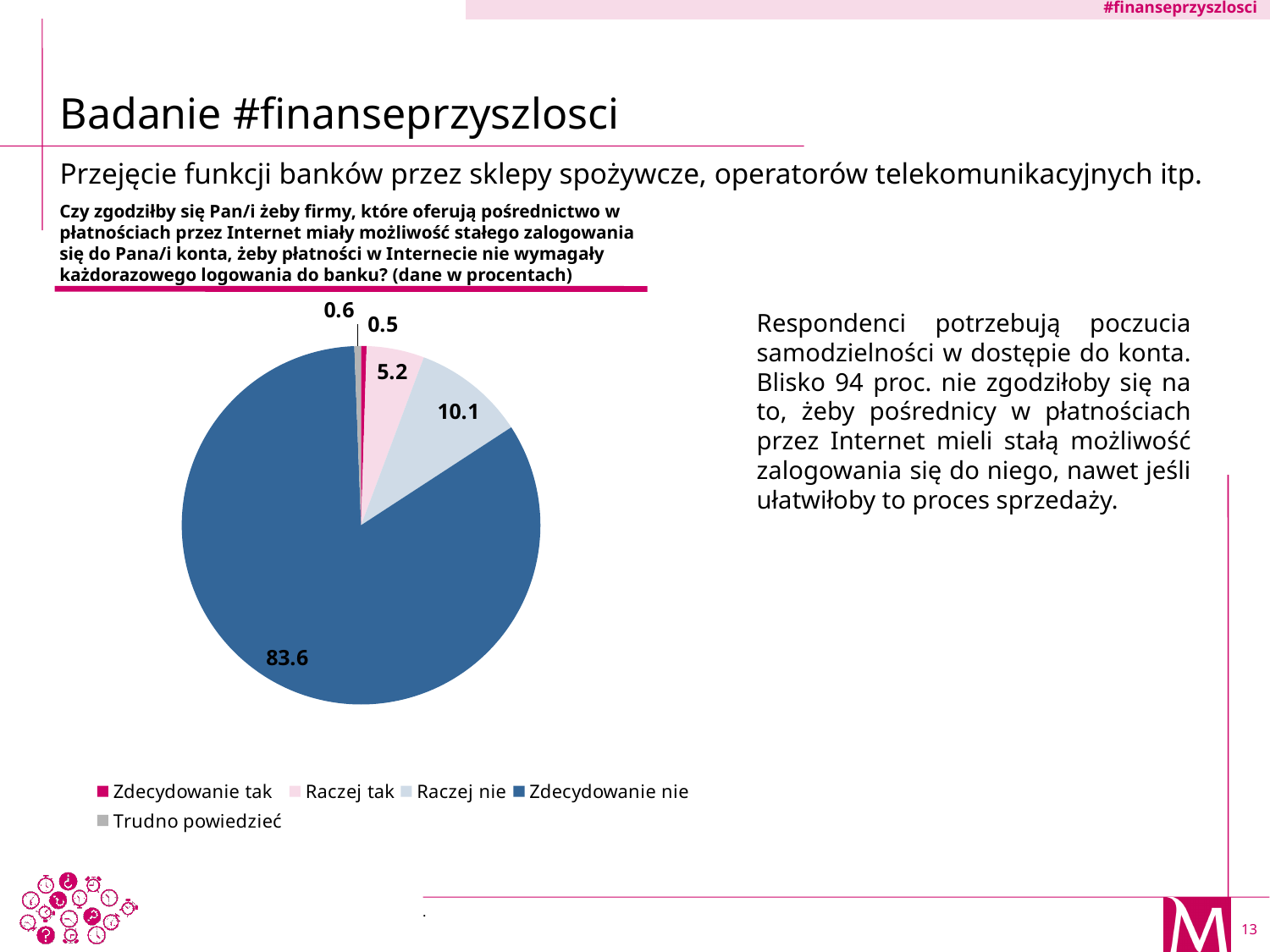
Which is larger, the value for "Raczej tak" or the value for "Raczej nie"? Raczej nie What is the combined share of the "Raczej nie" and "Zdecydowanie nie" slices? 93.7 What is the value for "Zdecydowanie tak" in the pie chart? 0.5 What is the value for "Trudno powiedzieć" in the pie chart? 0.6 How many categories does the legend of the pie chart list? 5 What type of chart is shown on the slide? pie chart Which category has the smallest slice of the pie chart? Zdecydowanie tak What is the value for "Raczej nie" in the pie chart? 10.1 What is the difference between the values for "Zdecydowanie nie" and "Raczej nie"? 73.5 What is the value for "Zdecydowanie nie" in the pie chart? 83.6 What is the value for "Raczej tak" in the pie chart? 5.2 Which category has the largest slice of the pie chart? Zdecydowanie nie